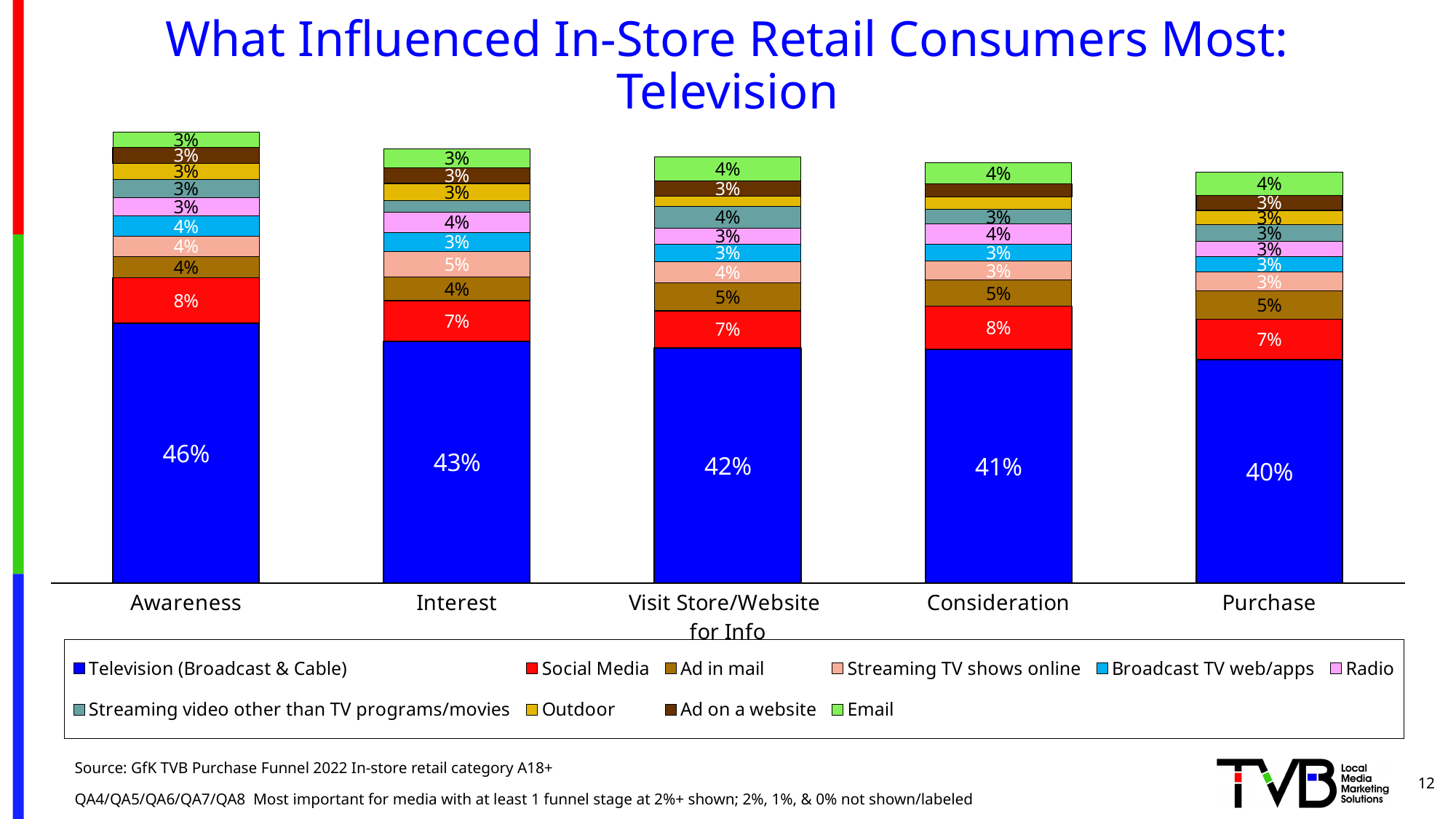
At which funnel stage is the Television (Broadcast & Cable) share highest? Awareness Does the Television (Broadcast & Cable) share rise or fall from Awareness to Purchase? Fall What percentage of in-store retail consumers cited Television (Broadcast & Cable) at the Awareness stage? 46% At which funnel stage is the Television (Broadcast & Cable) share lowest? Purchase What kind of chart is shown on the slide? Stacked bar chart How many funnel stages are shown on the x axis? 5 What is the Ad in mail value at the Visit Store/Website for Info stage? 5% What is the difference between the Television (Broadcast & Cable) values at Awareness and Purchase? 6 percentage points What is the Television (Broadcast & Cable) value for the Purchase stage? 40% How many media series does the legend list? 10 Which is larger: the Social Media value at Awareness or at Interest? Awareness What is the Social Media value at the Consideration stage? 8%